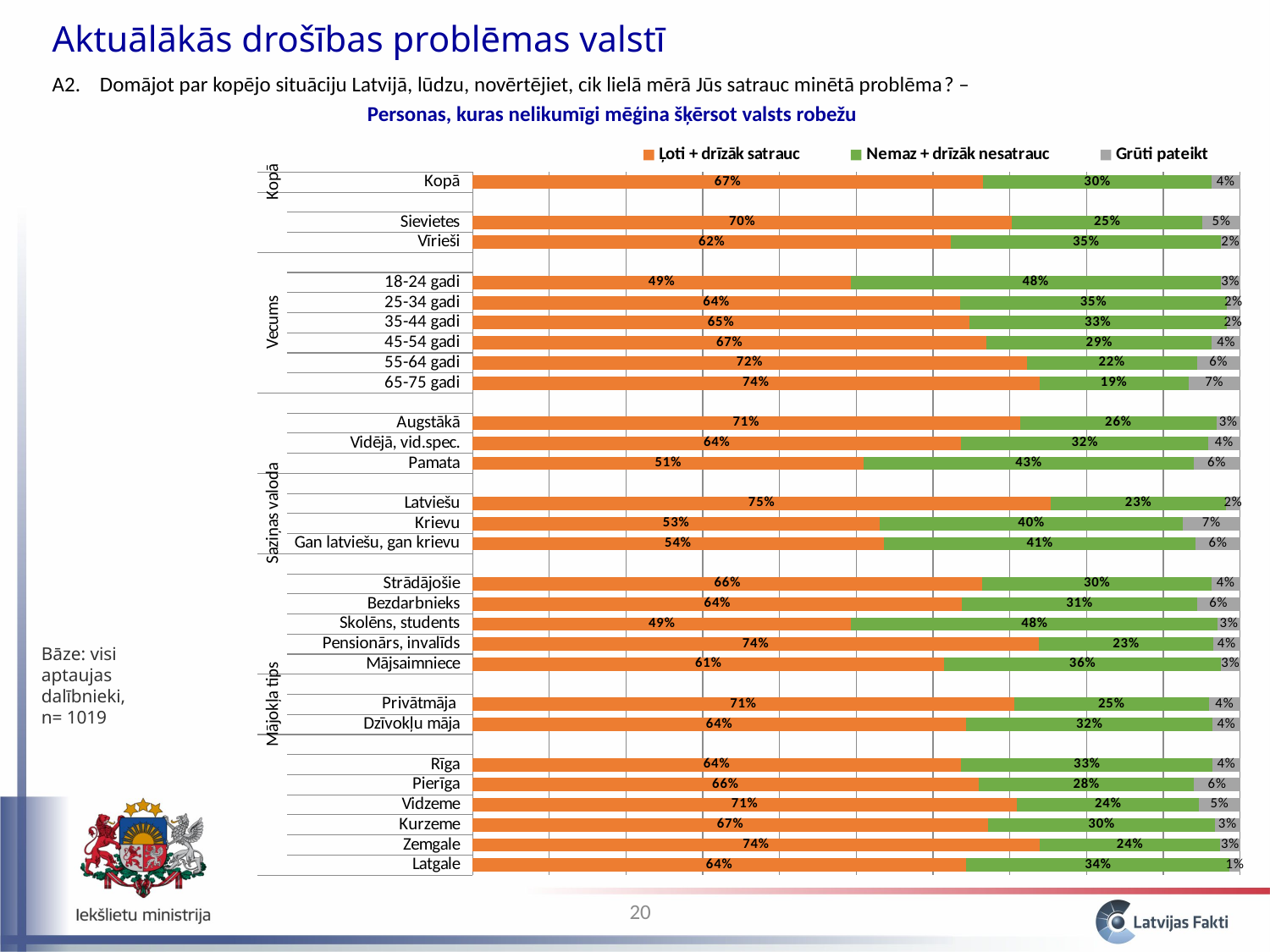
Which category has the lowest "Grūti pateikt" value? Latgale Do the "Ļoti + drīzāk satrauc" values rise or fall as the age groups go from 18-24 gadi to 65-75 gadi? Rise How many data series does the legend list? 3 What is the title of the chart? Personas, kuras nelikumīgi mēģina šķērsot valsts robežu Which category has the highest "Ļoti + drīzāk satrauc" value? Latviešu What is the difference between the "Ļoti + drīzāk satrauc" values for Sievietes and Vīrieši? 8 percentage points What is the "Nemaz + drīzāk nesatrauc" value for the 18-24 gadi group? 48% Which has a larger "Nemaz + drīzāk nesatrauc" value, Pamata or Augstākā? Pamata What is the "Grūti pateikt" value for Krievu? 7% Which has a larger "Ļoti + drīzāk satrauc" value, Zemgale or Rīga? Zemgale What percentage of respondents overall (Kopā) answered "Ļoti + drīzāk satrauc"? 67% What kind of chart is shown on the slide? Stacked horizontal bar chart